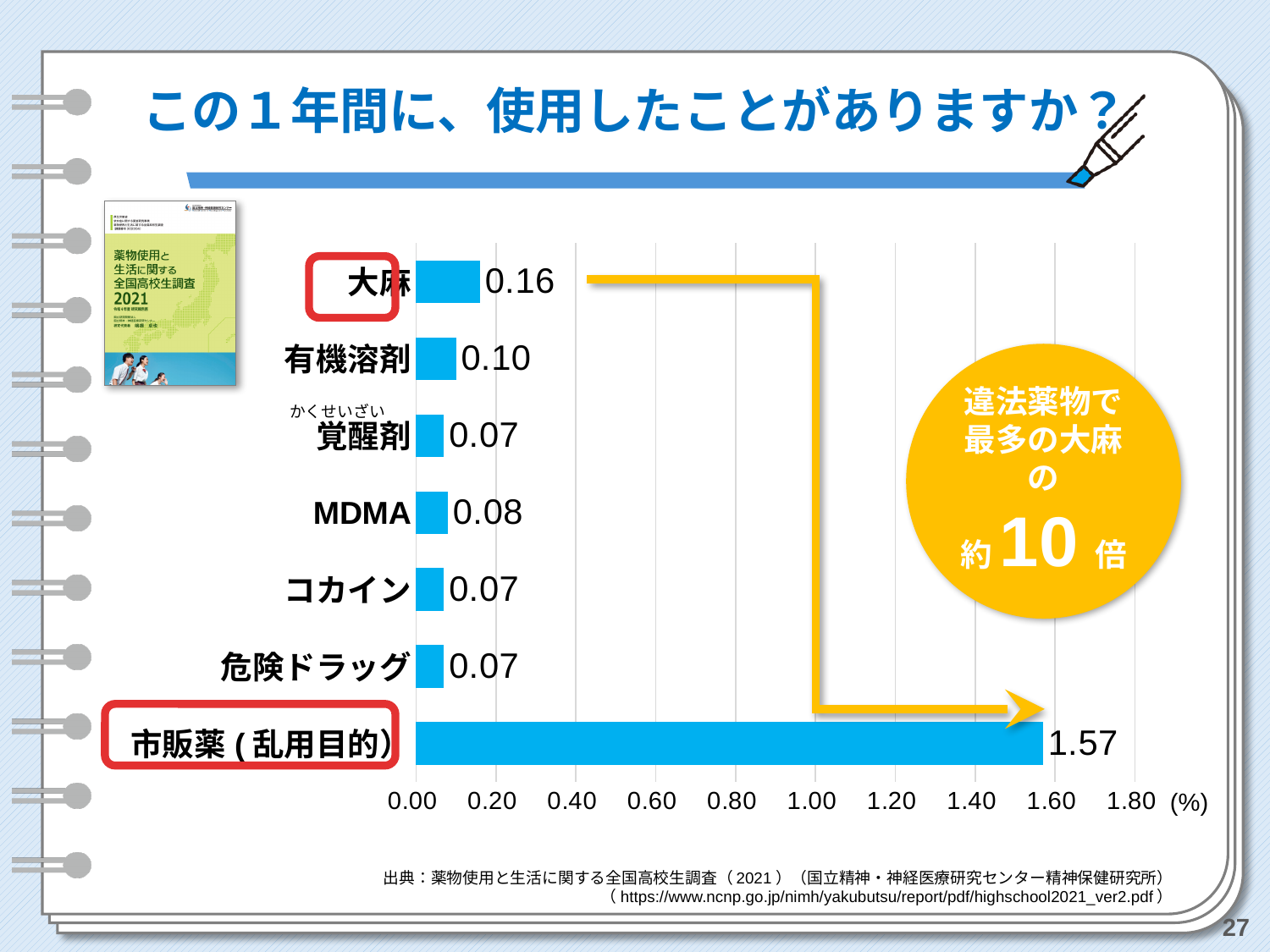
What is the value for 市販薬(乱用目的)? 1.57 How many categories are shown in the chart? 7 What kind of chart is shown on the slide? bar chart What unit is shown on the horizontal axis of the chart? % What is the difference between the values for 大麻 and 有機溶剤? 0.06 Which is larger, the value for 大麻 or the value for MDMA? 大麻 Which category has the highest value? 市販薬(乱用目的) What is the value for MDMA? 0.08 What is the difference between the values for 市販薬(乱用目的) and 大麻? 1.41 What is the value for 有機溶剤? 0.10 Is the value for 市販薬(乱用目的) greater or less than 1.00? greater What is the value for 大麻? 0.16